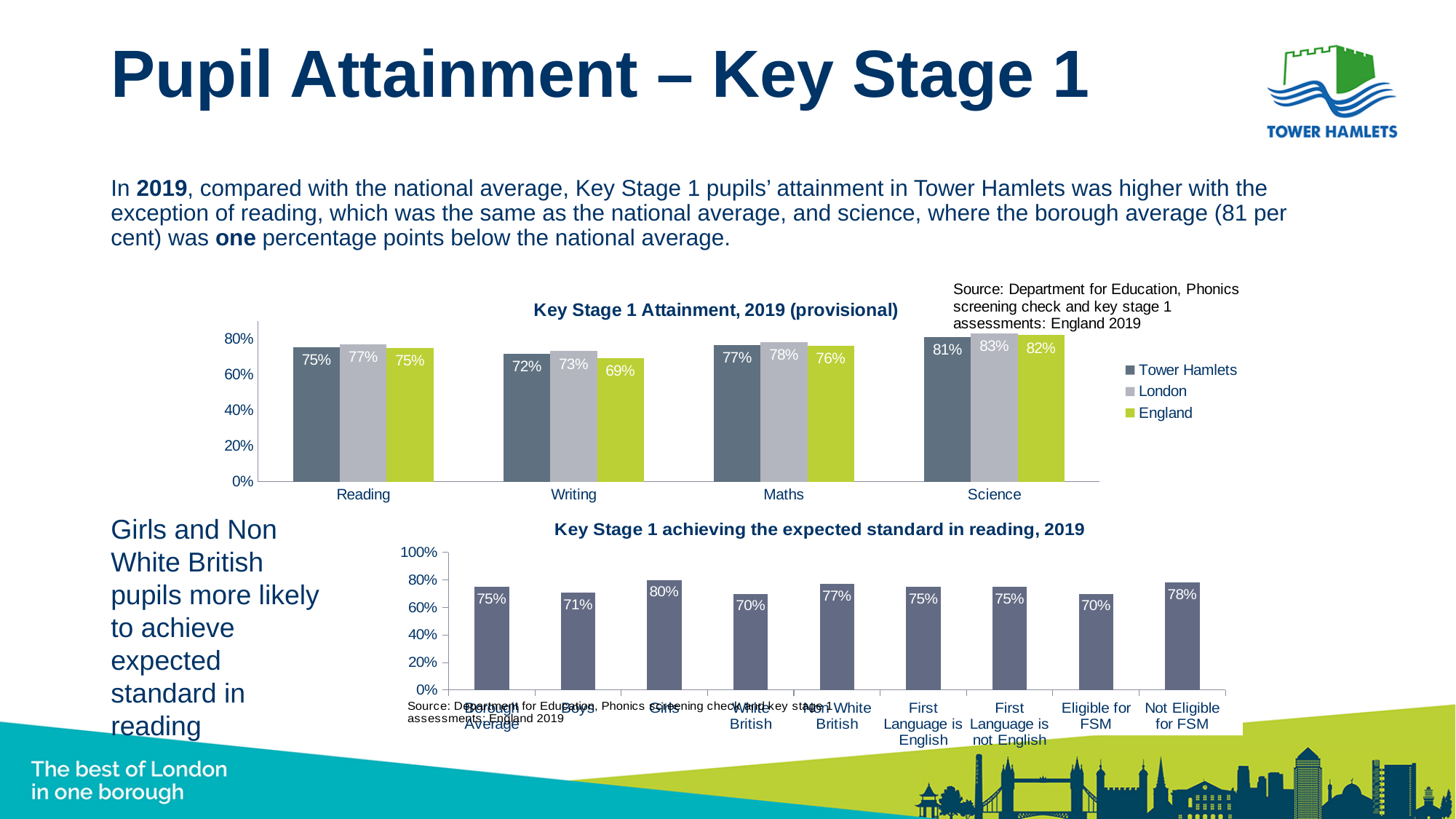
In the 'Key Stage 1 Attainment, 2019 (provisional)' chart, what is the England value for Writing? 69% In the 'Key Stage 1 Attainment, 2019 (provisional)' chart, what is the Tower Hamlets value for Science? 81% In the 'Key Stage 1 achieving the expected standard in reading, 2019' chart, what is the value for Non White British? 77% In the 'Key Stage 1 achieving the expected standard in reading, 2019' chart, what is the value for Not Eligible for FSM? 78% In the 'Key Stage 1 Attainment, 2019 (provisional)' chart, what is the London value for Maths? 78% What type of chart is the 'Key Stage 1 achieving the expected standard in reading, 2019' chart? bar chart In the 'Key Stage 1 Attainment, 2019 (provisional)' chart, what is the difference between the London and Tower Hamlets values for Science? 2% In the 'Key Stage 1 Attainment, 2019 (provisional)' chart, which subject has the highest Tower Hamlets value? Science In the 'Key Stage 1 achieving the expected standard in reading, 2019' chart, which category has the highest value? Girls In the 'Key Stage 1 Attainment, 2019 (provisional)' chart, how many series does the legend list? 3 In the 'Key Stage 1 achieving the expected standard in reading, 2019' chart, what is the difference between Non White British and White British? 7% In the 'Key Stage 1 Attainment, 2019 (provisional)' chart, is the Tower Hamlets value for Writing larger or smaller than the England value for Writing? larger